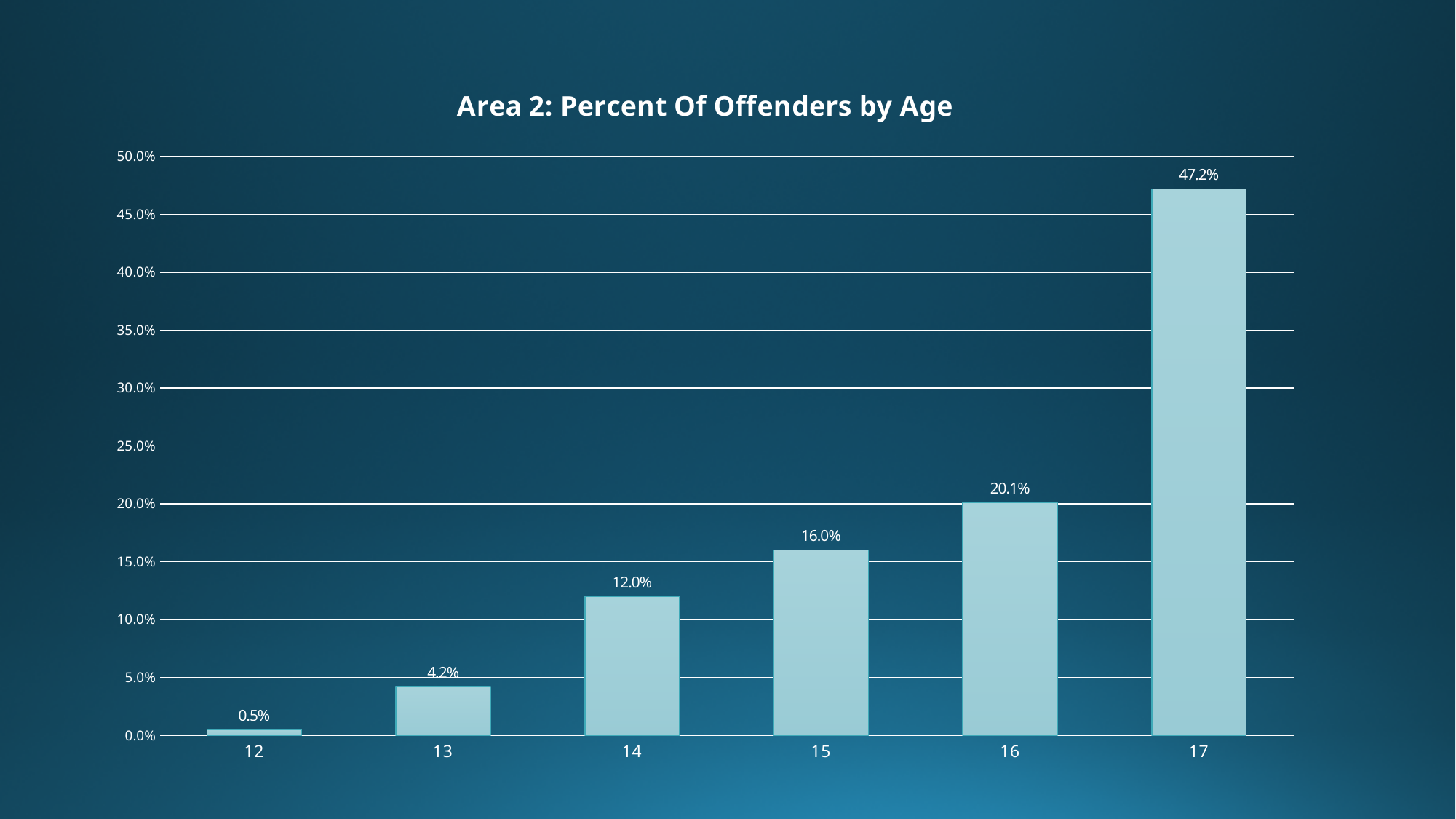
Do the values rise or fall as age increases from 12 to 17? rise Which age has the highest percent of offenders? 17 What is the percent of offenders for age 14? 12.0% What is the percent of offenders for age 17? 47.2% What kind of chart is shown on the slide? bar chart How many age categories are shown on the chart? 6 Which age has a larger percent of offenders, 15 or 16? 16 What is the difference between the percent of offenders for age 15 and age 13? 11.8% Which age has the lowest percent of offenders? 12 What is the percent of offenders for age 12? 0.5% Is the value for age 16 greater or less than 25.0%? less What is the difference between the percent of offenders for age 17 and age 16? 27.1%